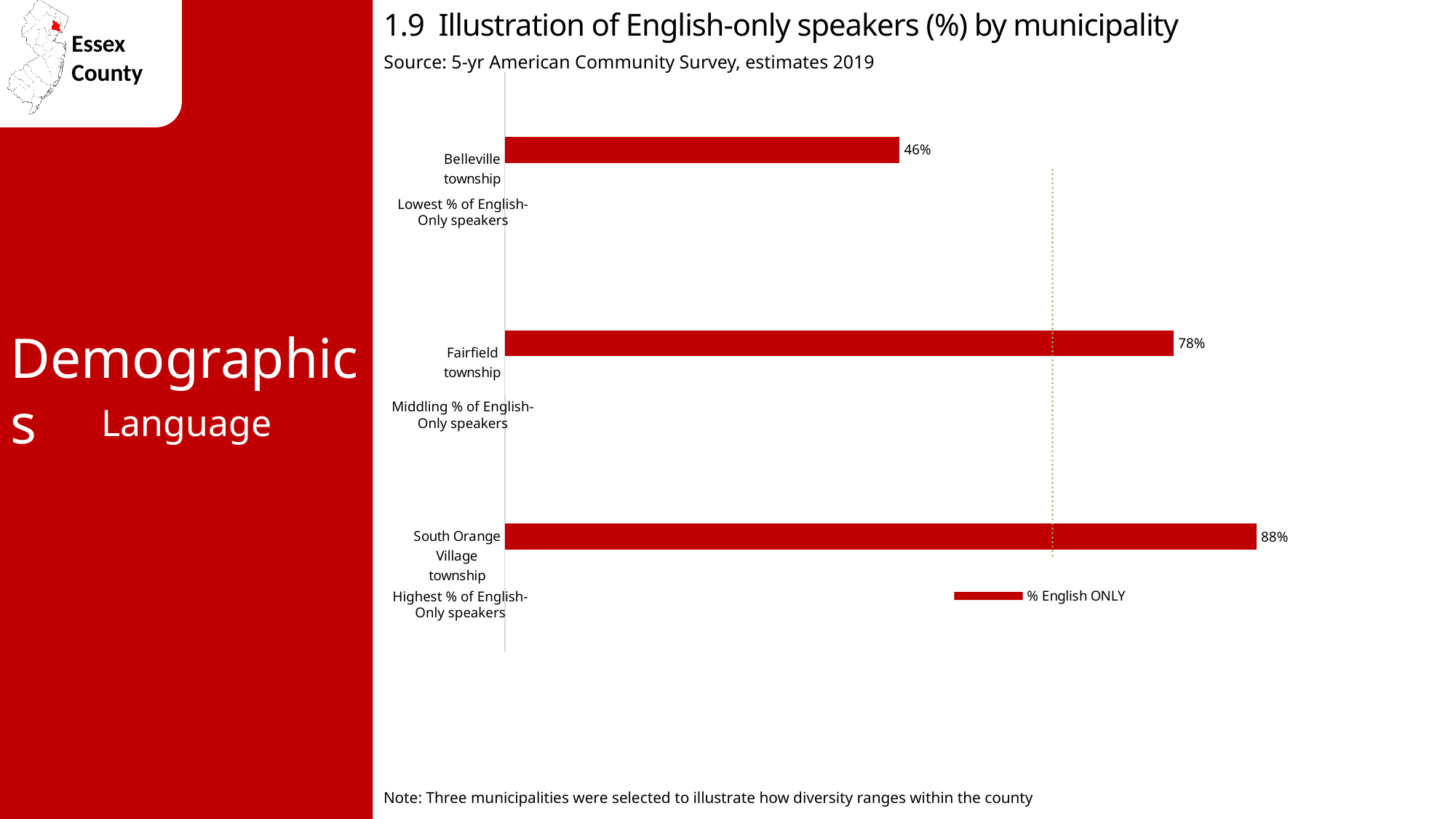
How many series does the legend list? 1 How many municipalities are shown in the chart? 3 Which municipality has the lowest percentage of English-only speakers? Belleville township What is the difference in percentage points between Fairfield township and Belleville township? 32 Which municipality has the highest percentage of English-only speakers? South Orange Village township What is the percentage of English-only speakers in Belleville township? 46% What is the difference in percentage points between South Orange Village township and Belleville township? 42 What is the series name shown in the chart legend? % English ONLY What kind of chart is shown on the slide? Bar chart What is the percentage of English-only speakers in South Orange Village township? 88% Which has a higher percentage of English-only speakers, Fairfield township or Belleville township? Fairfield township What is the percentage of English-only speakers in Fairfield township? 78%